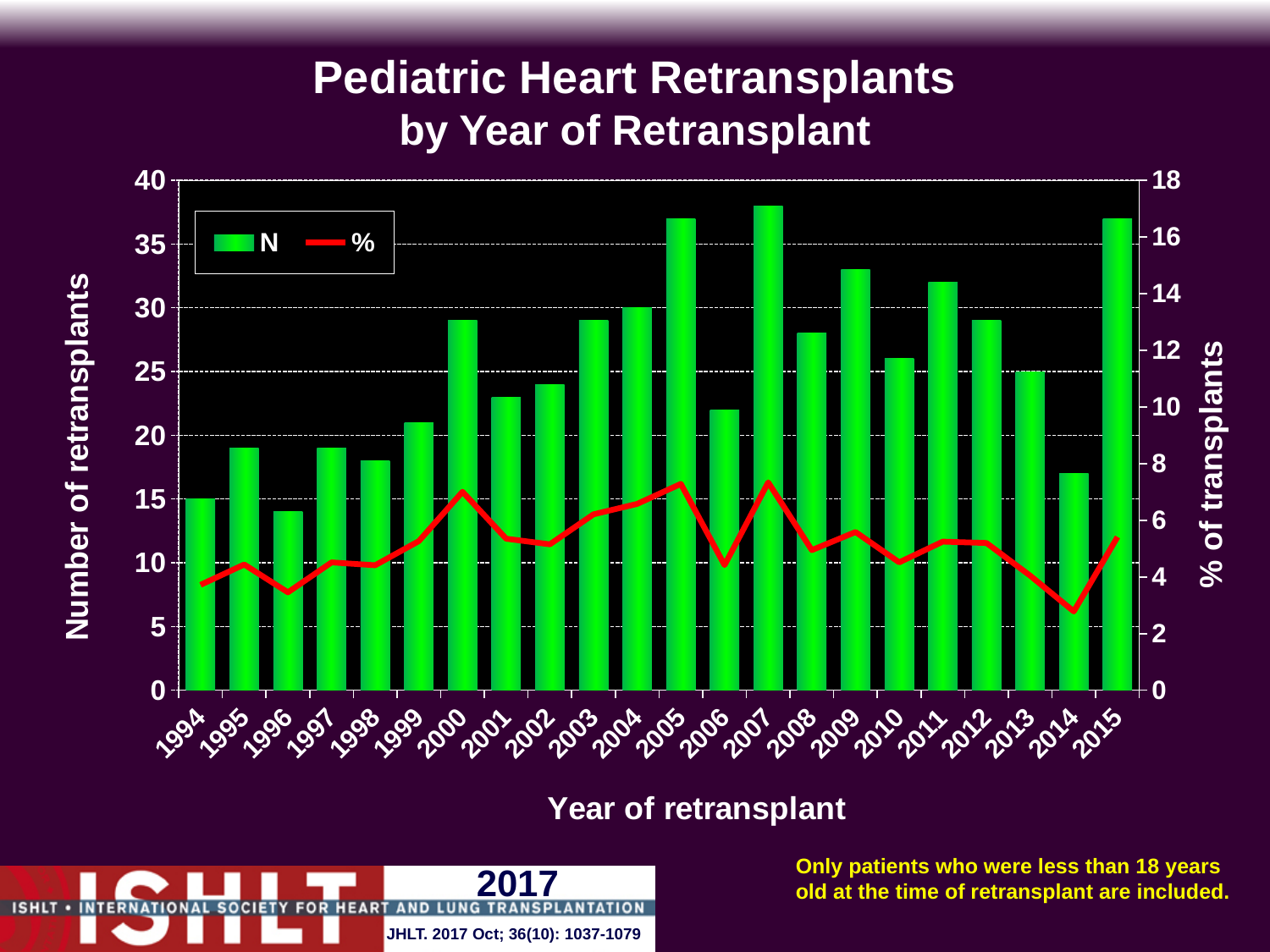
Do the number of retransplants rise or fall from 2012 to 2014? fall Is the number of retransplants in 2014 greater or less than 20? less How many years are shown on the x axis? 22 Which year had more retransplants, 2005 or 2006? 2005 Which year had more retransplants, 2014 or 2015? 2015 Which series is plotted as green bars? N How many series does the legend list? 2 In which year is the % of transplants line at its lowest? 2014 Is the number of retransplants in 1996 greater or less than 15? less What kind of chart is shown on the slide? A combined bar and line chart What is the label of the right-hand y axis? % of transplants Is the number of retransplants in 2007 greater or less than 35? greater